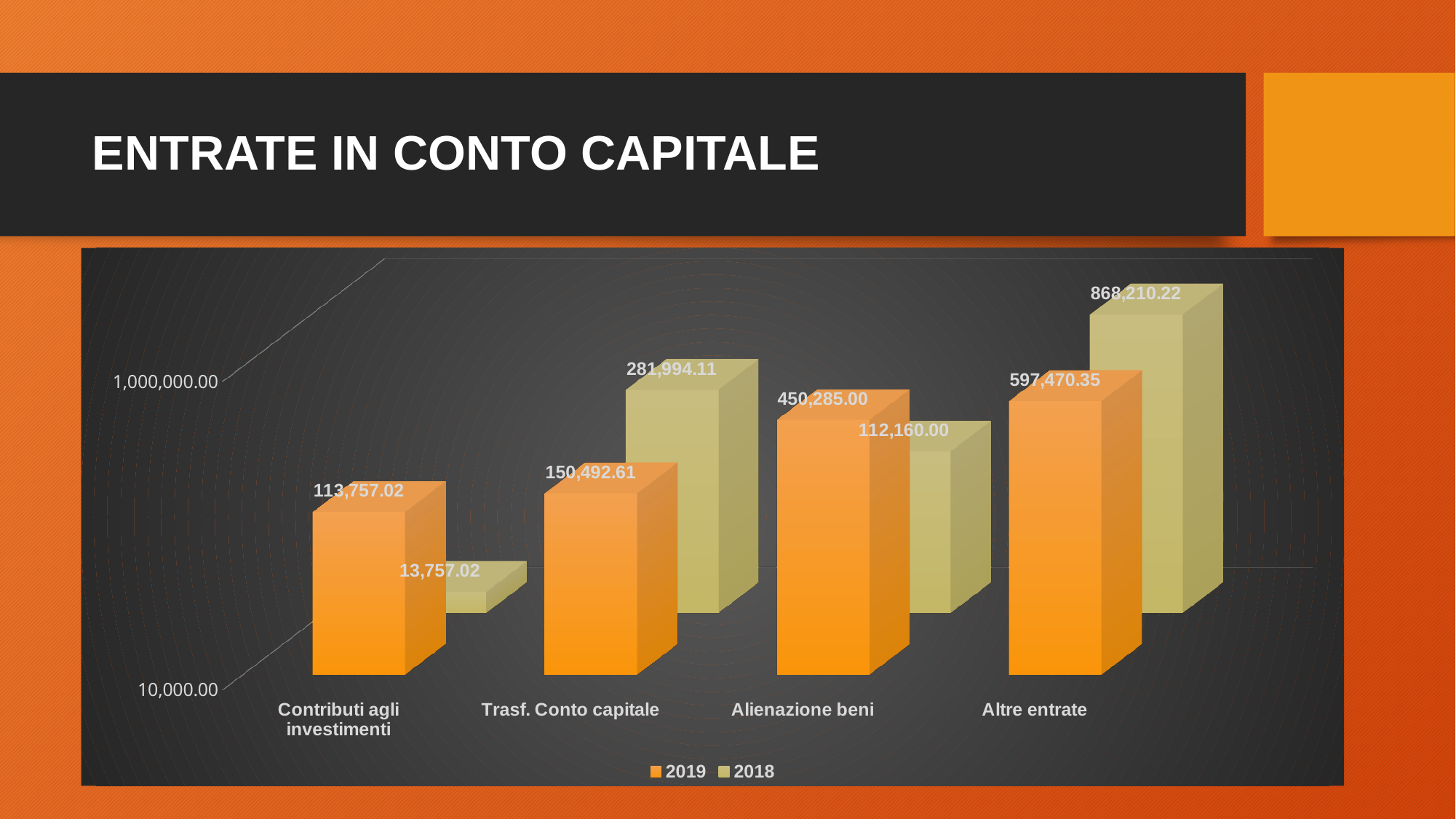
What is the difference between the 2018 and 2019 values for Altre entrate? 270,739.87 What is the 2019 value for Altre entrate? 597,470.35 Do the 2019 values rise or fall from Contributi agli investimenti to Altre entrate? rise How many series does the legend list? 2 What is the 2018 value for Contributi agli investimenti? 13,757.02 What is the difference between the 2019 and 2018 values for Contributi agli investimenti? 100,000.00 What is the 2018 value for Trasf. Conto capitale? 281,994.11 What is the 2019 value for Alienazione beni? 450,285.00 How many categories are shown on the x axis? 4 Which category has the highest 2018 value? Altre entrate Which category has the lowest 2019 value? Contributi agli investimenti For Alienazione beni, which year has the larger value, 2019 or 2018? 2019